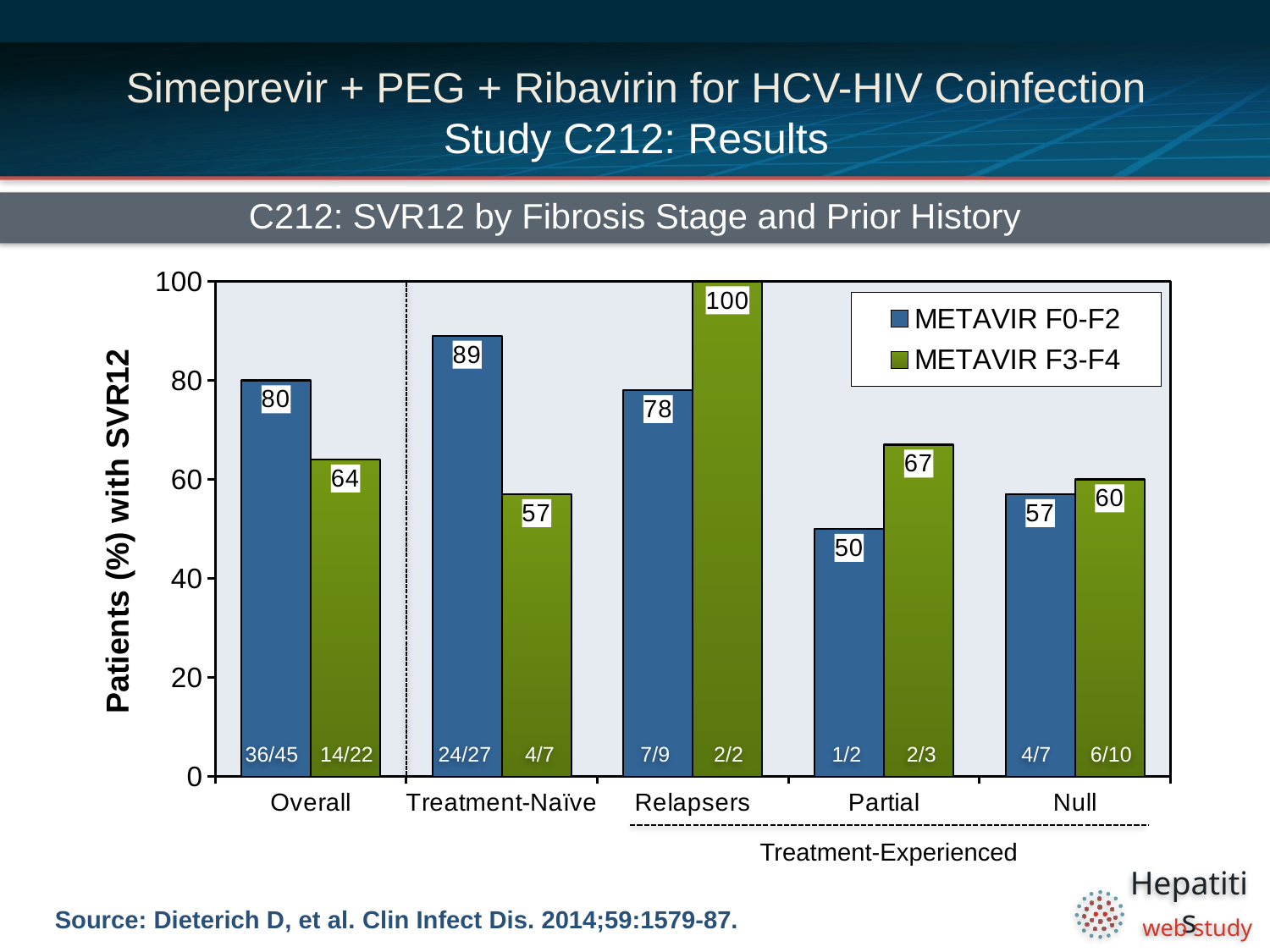
How many categories are shown on the x axis? 5 What is the patient fraction shown for METAVIR F0-F2 in the Overall group? 36/45 Which category has the lowest SVR12 rate for METAVIR F0-F2? Partial What is the SVR12 rate for METAVIR F3-F4 patients among Relapsers? 100 What is the difference between the METAVIR F0-F2 and METAVIR F3-F4 SVR12 rates in the Treatment-Naïve group? 32 What is the SVR12 rate for METAVIR F3-F4 patients in the Treatment-Naïve group? 57 How many series does the legend list? 2 In the Partial group, which fibrosis stage has the higher SVR12 rate? METAVIR F3-F4 Which category has the highest SVR12 rate for METAVIR F3-F4? Relapsers Is the SVR12 rate for METAVIR F0-F2 in the Null group greater or less than 60? less What kind of chart is shown? Bar chart What is the SVR12 rate for METAVIR F0-F2 patients in the Overall group? 80